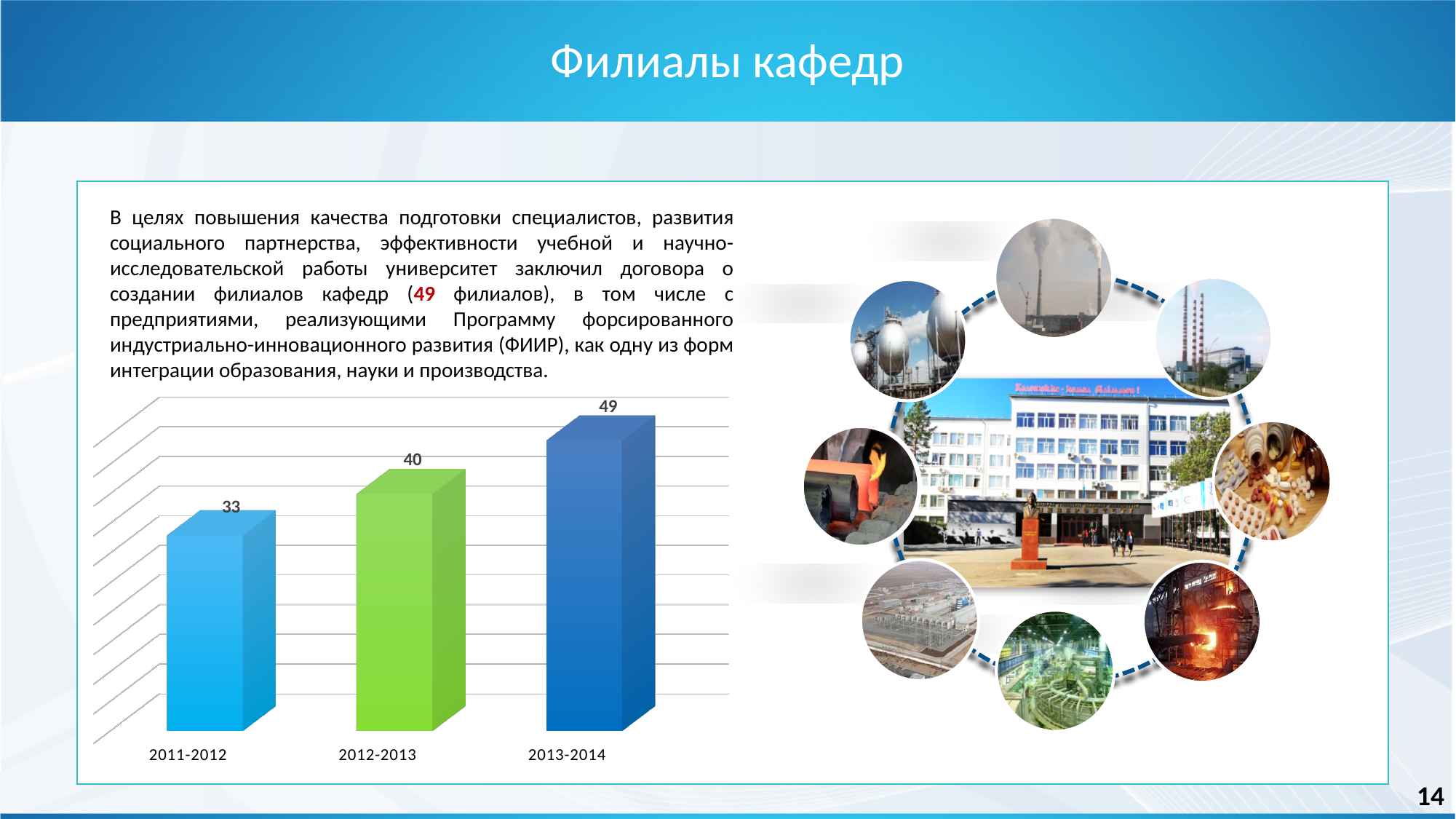
What is the difference between the values for 2012-2013 and 2011-2012? 7 What colour is the bar for 2012-2013? green What is the difference between the values for 2013-2014 and 2011-2012? 16 Which category has the highest value? 2013-2014 What is the value for 2013-2014? 49 What is the value for 2012-2013? 40 How many categories are shown on the x axis of the chart? 3 What is the value for 2011-2012? 33 What kind of chart is shown on the slide? bar chart Which is larger, the value for 2012-2013 or the value for 2013-2014? 2013-2014 Do the values rise or fall from 2011-2012 to 2013-2014? rise Which category has the lowest value? 2011-2012